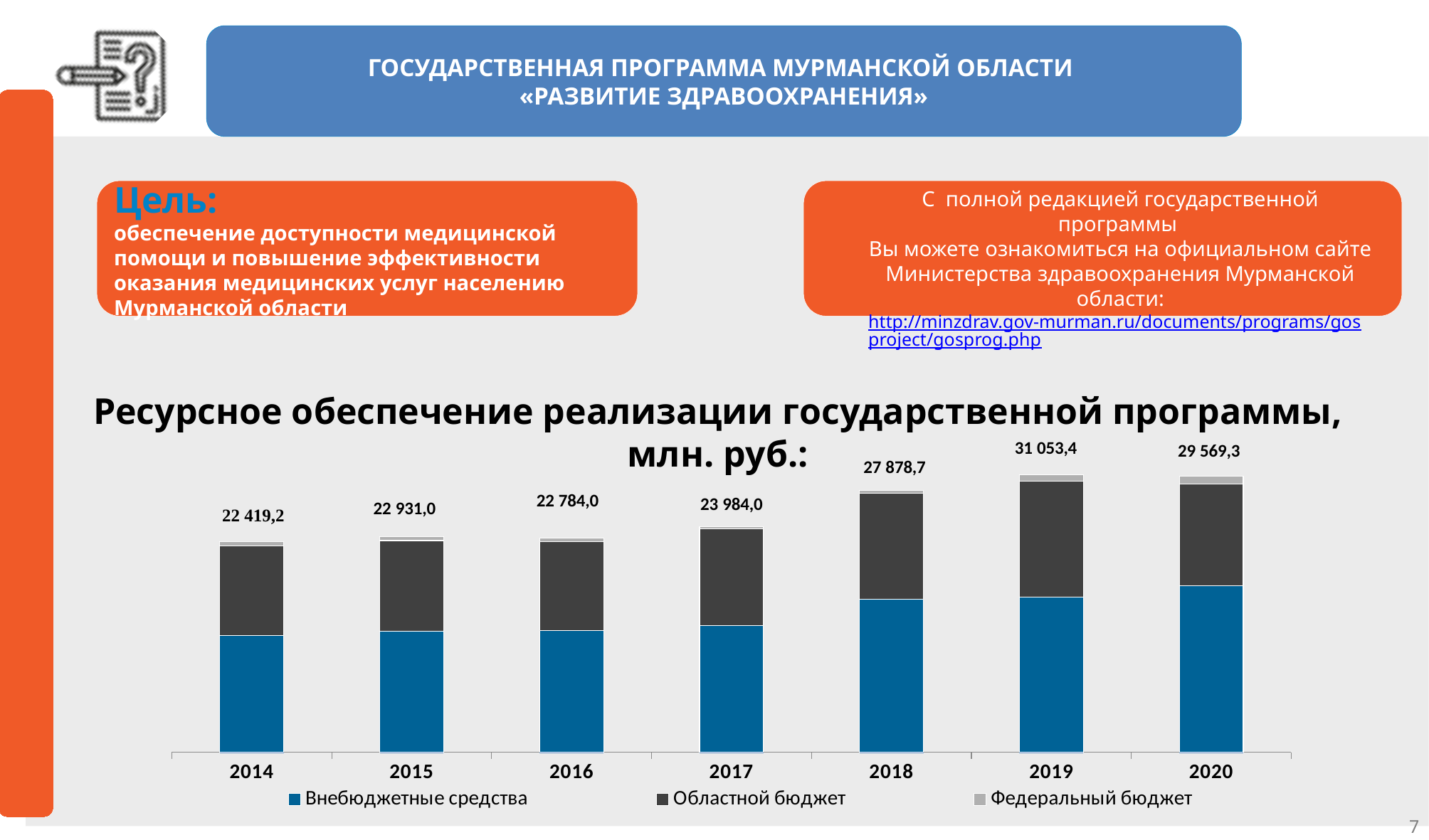
Which year has the lowest total resource provision? 2014 What is the total resource provision shown for 2019? 31 053,4 What is the total value labelled above the bar for 2014? 22 419,2 What is the difference between the total for 2019 and the total for 2020? 1 484,1 What is the difference between the total for 2018 and the total for 2017? 3 894,7 What is the total value labelled for 2017? 23 984,0 Which year has the highest total resource provision? 2019 Which series is shown in blue in the legend? Внебюджетные средства How many years are shown on the x axis of the chart? 7 What kind of chart is shown on the slide? Stacked bar chart Which is larger, the total for 2015 or the total for 2016? 2015 How many series does the legend list? 3